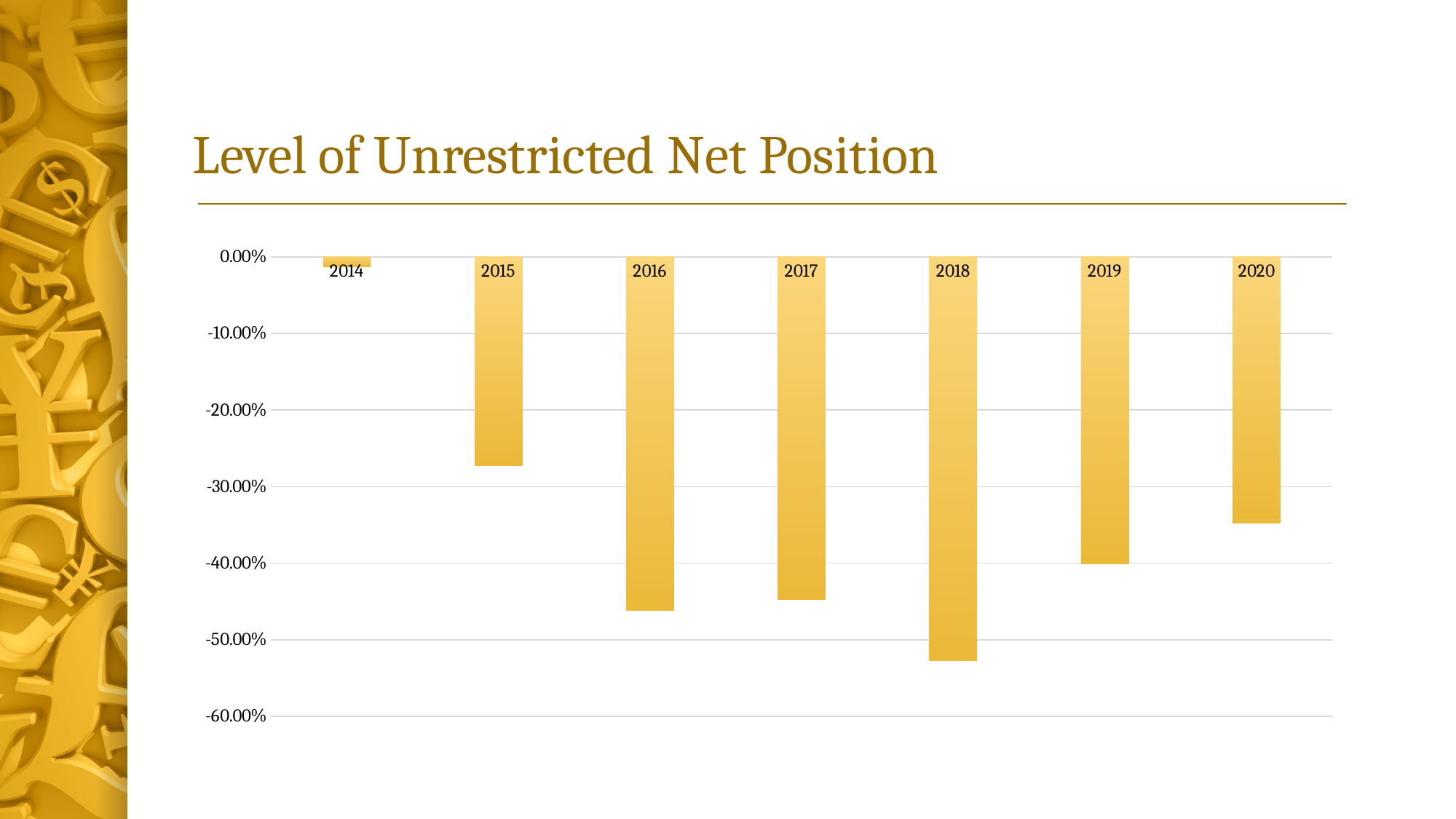
Is the value for 2015 greater or less than -20.00%? less Is the value for 2016 greater or less than -40.00%? less Is the value for 2020 greater or less than -40.00%? greater Which bar extends further below zero, 2018 or 2019? 2018 Which year has the highest value (closest to zero)? 2014 Which year has the lowest (most negative) value? 2018 Which bar extends further below zero, 2015 or 2020? 2020 From 2014 to 2018, do the values rise or fall? fall What is the title of the chart? Level of Unrestricted Net Position What kind of chart is shown on the slide? bar chart How many years are plotted on the chart? 7